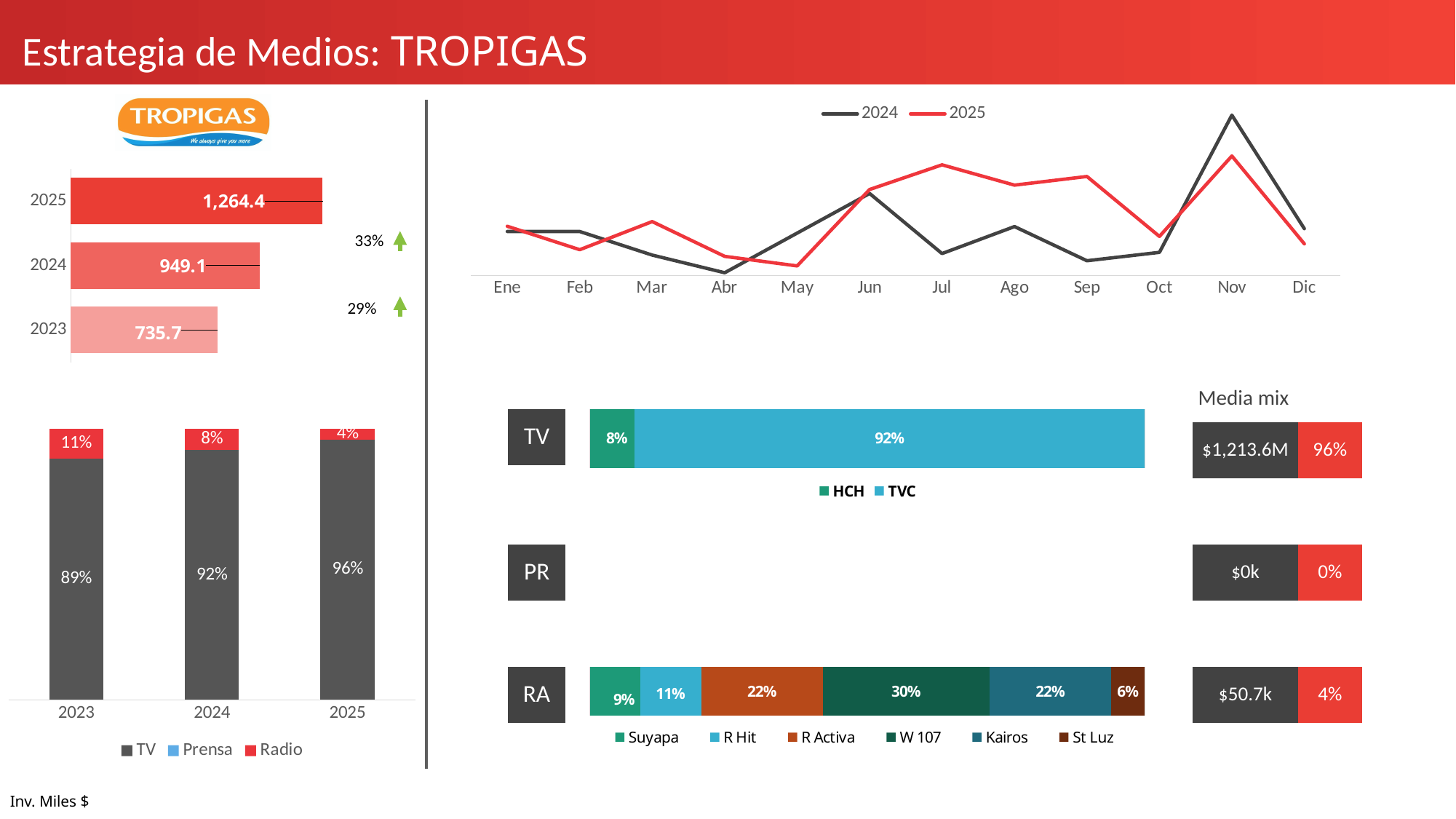
In the RA stacked bar chart at the bottom right, which station has the largest share? W 107 In the bottom-left stacked bar chart, what is the Radio share for 2025? 4% In the bottom-left stacked bar chart, what is the TV share for 2024? 92% In the top-right line chart, which month has the highest value for the 2024 series? Nov In the top-left horizontal bar chart, which year has the lowest value? 2023 In the top-left horizontal bar chart, what is the difference between the 2025 and 2024 values? 315.3 In the top-left horizontal bar chart, how many years are shown? 3 In the bottom-left stacked bar chart, how many series does the legend list? 3 In the top-left horizontal bar chart, what is the value for 2023? 735.7 In the top-left horizontal bar chart, what is the value for 2025? 1,264.4 In the bottom-left stacked bar chart, does the Radio share rise or fall from 2023 to 2025? fall In the top-right line chart, how many series does the legend list? 2